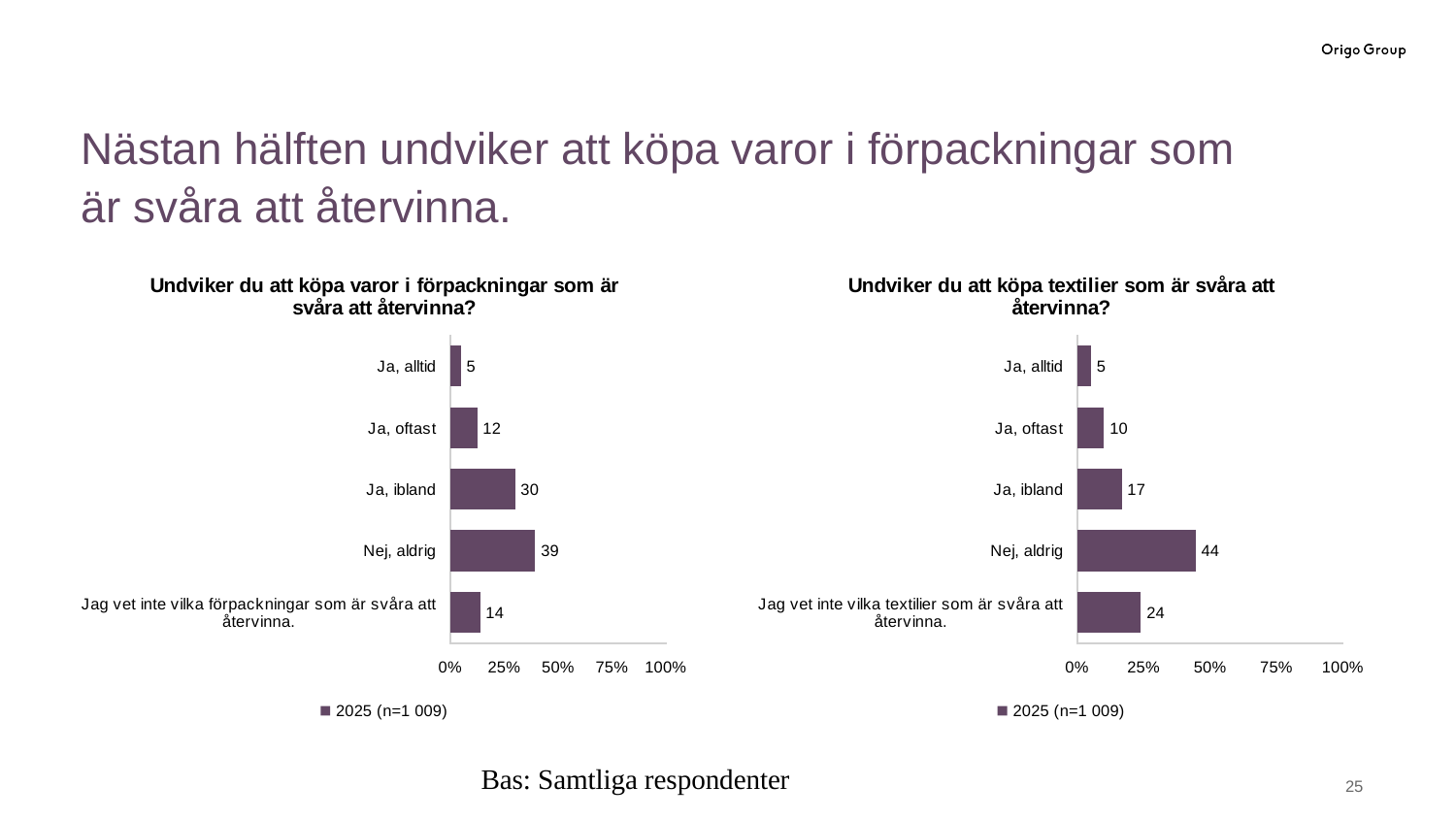
In the left chart ("Undviker du att köpa varor i förpackningar som är svåra att återvinna?"), what is the value for "Nej, aldrig"? 39 In the left chart about förpackningar, what is the difference between "Nej, aldrig" and "Ja, ibland"? 9 In the left chart about förpackningar, which category has the highest value? Nej, aldrig In the right chart about textilier, what is the difference between "Nej, aldrig" and "Jag vet inte vilka textilier som är svåra att återvinna."? 20 In the right chart about textilier, which category has the lowest value? Ja, alltid What is the legend entry shown under the left chart about förpackningar? 2025 (n=1 009) Which is larger: "Ja, ibland" in the left chart about förpackningar or "Ja, ibland" in the right chart about textilier? Left chart (förpackningar) How many series does the legend of the right chart about textilier list? 1 What kind of chart is the left chart about förpackningar? Bar chart How many categories are shown in the left chart about förpackningar? 5 In the right chart about textilier, is the value for "Nej, aldrig" greater or less than 25%? greater In the right chart ("Undviker du att köpa textilier som är svåra att återvinna?"), what is the value for "Ja, ibland"? 17